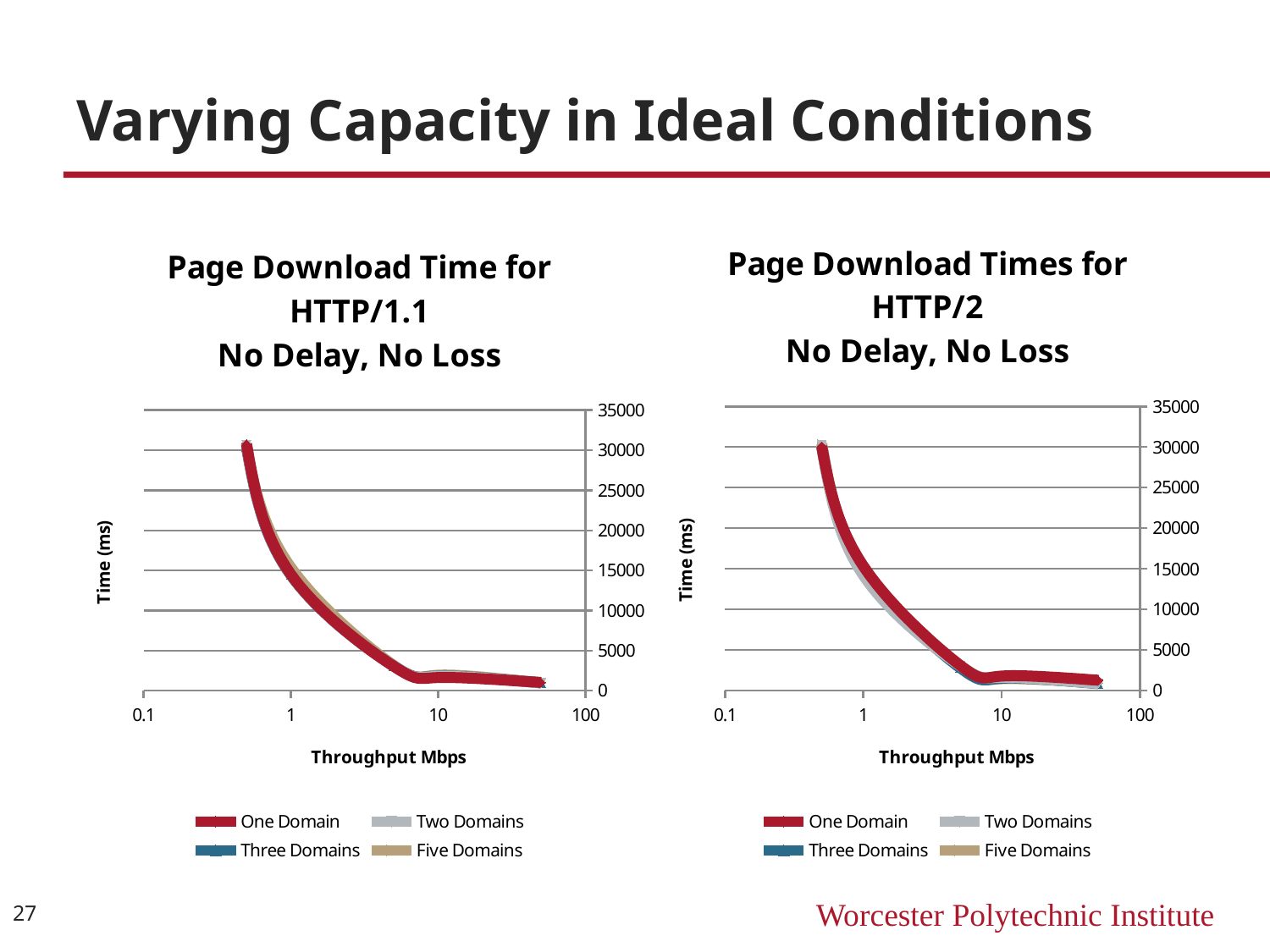
In the HTTP/1.1 chart, is the One Domain value at 10 Mbps throughput greater or less than 5000? less How many series does the legend of the HTTP/1.1 chart list? 4 In the HTTP/1.1 chart, do the page download times rise or fall as throughput increases along the x axis? fall What kind of chart is the 'Page Download Time for HTTP/1.1 No Delay, No Loss' chart? line chart What kind of chart is the 'Page Download Times for HTTP/2 No Delay, No Loss' chart? line chart In the HTTP/2 chart, is the One Domain value at 10 Mbps throughput greater or less than 5000? less What is the y-axis label on the HTTP/1.1 chart? Time (ms) How many series does the legend of the HTTP/2 chart list? 4 What is the x-axis label on the HTTP/2 chart? Throughput Mbps In the HTTP/1.1 chart, is the highest One Domain value greater or less than 25000? greater In the HTTP/2 chart, do the page download times rise or fall as throughput increases along the x axis? fall